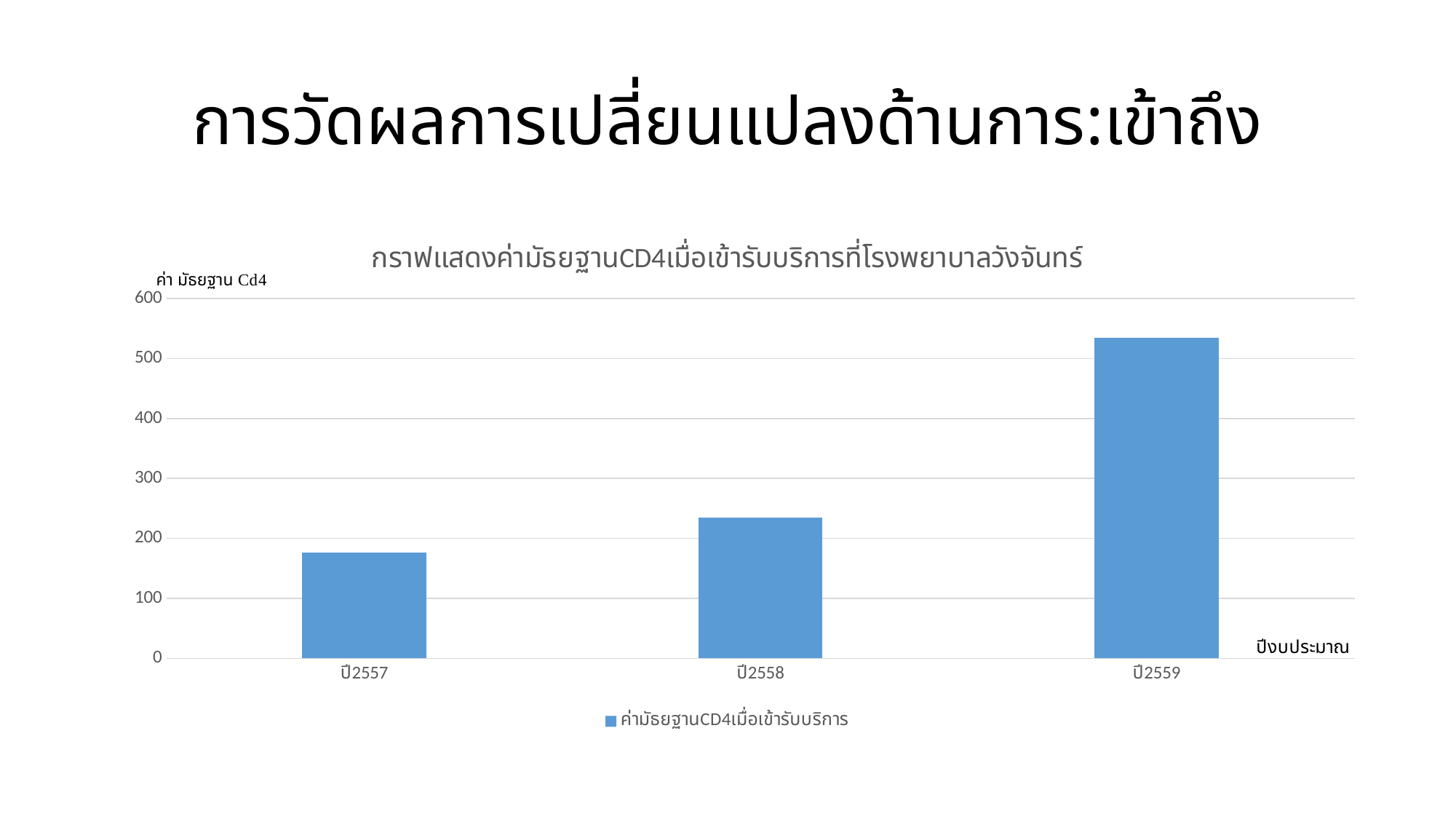
What series name is shown in the legend? ค่ามัธยฐานCD4เมื่อเข้ารับบริการ What is the title of the chart? กราฟแสดงค่ามัธยฐานCD4เมื่อเข้ารับบริการที่โรงพยาบาลวังจันทร์ How many series does the legend list? 1 How many categories (years) are plotted on the x axis? 3 Which is larger, the value for ปี2558 or the value for ปี2557? ปี2558 What kind of chart is shown on the slide? bar chart Do the values rise or fall from ปี2557 to ปี2559? rise Is the value for ปี2557 greater or less than 200? less Which year has the lowest median CD4 value? ปี2557 Which year has the highest median CD4 value? ปี2559 Is the value for ปี2558 greater or less than 200? greater Is the value for ปี2559 greater or less than 500? greater